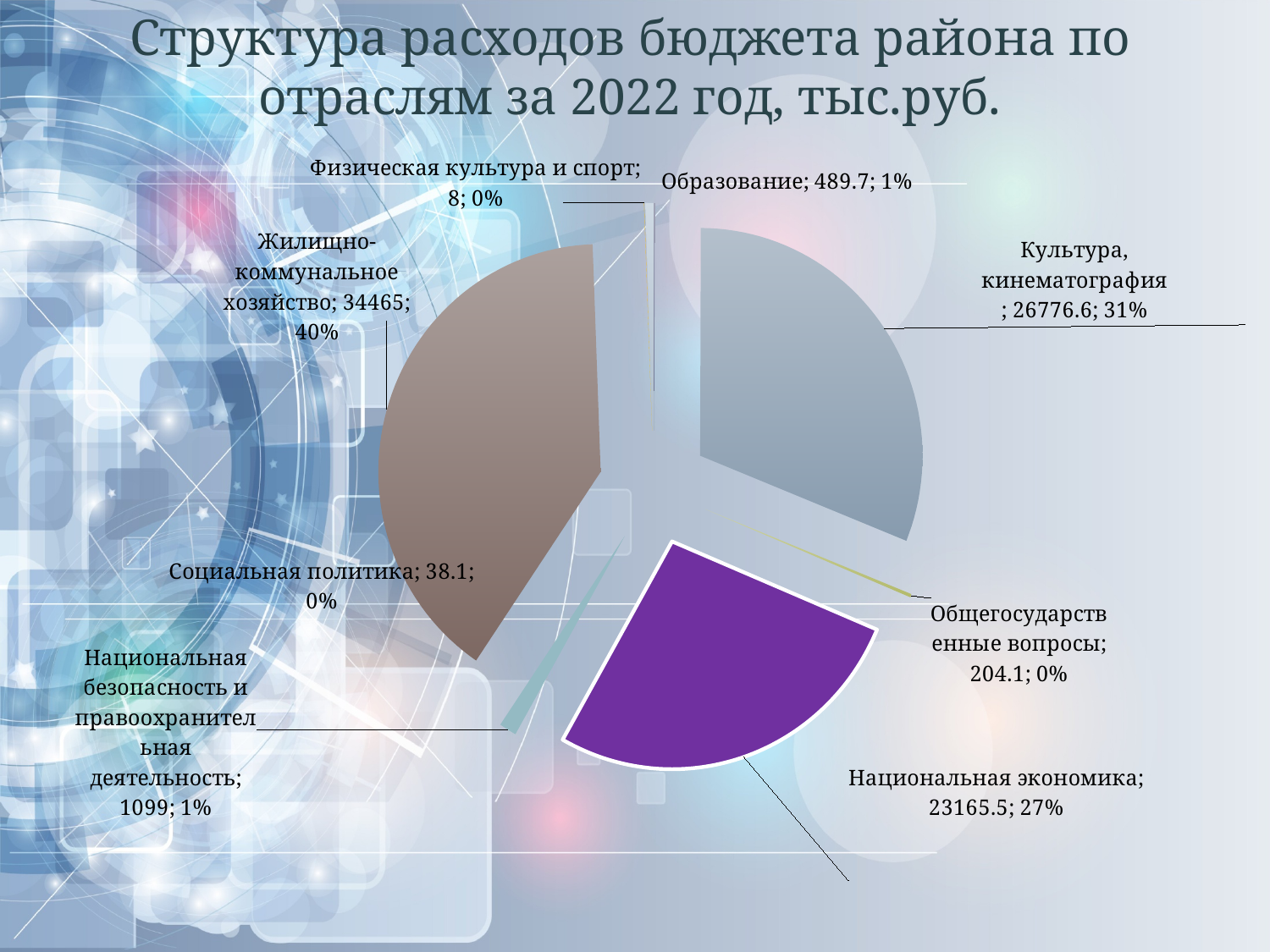
What is the difference between the values for Жилищно-коммунальное хозяйство and Культура, кинематография? 7688.4 What is the value for Жилищно-коммунальное хозяйство? 34465 What is the value for Образование? 489.7 What share of the pie does Национальная экономика take? 27% What is the value for Национальная экономика? 23165.5 Which category has the largest value? Жилищно-коммунальное хозяйство What share of the pie does Культура, кинематография take? 31% Which category has the smallest value? Физическая культура и спорт Which is larger, the value for Национальная безопасность и правоохранительная деятельность or the value for Образование? Национальная безопасность и правоохранительная деятельность What is the value for Культура, кинематография? 26776.6 How many categories does the pie chart show? 8 What kind of chart is shown on the slide? Pie chart